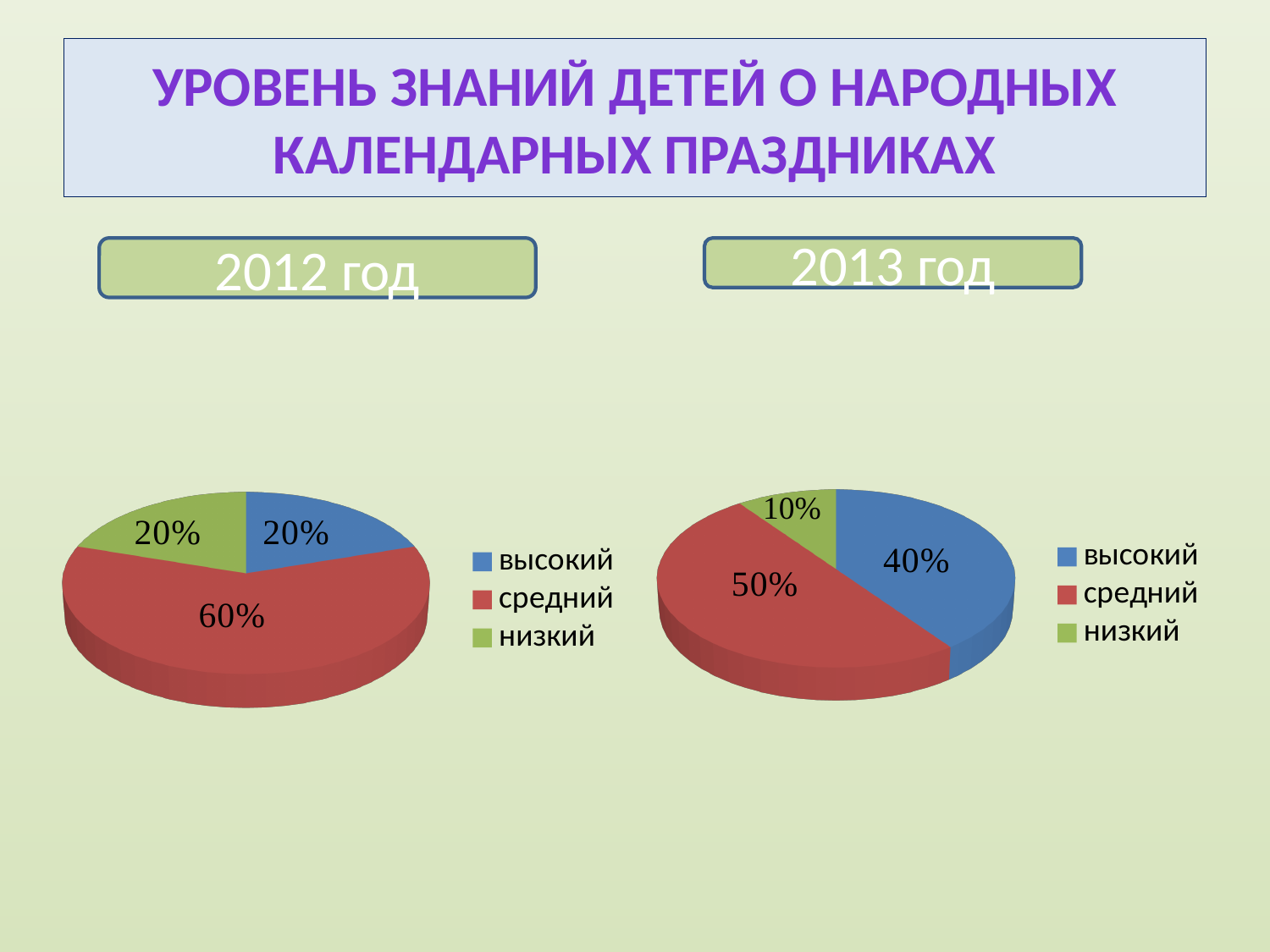
In the 2012 год pie chart, what share does the высокий slice have? 20% In the 2013 год pie chart, which is larger: the средний slice or the высокий slice? средний In the 2012 год pie chart, what share does the средний slice have? 60% In the 2013 год pie chart, what share does the высокий slice have? 40% In the 2013 год pie chart, which category has the smallest slice? низкий In the 2013 год pie chart, what share does the низкий slice have? 10% In the 2012 год pie chart, which category has the largest slice? средний Which colour represents низкий in the legend of the 2012 год chart? Green How many slices does the 2012 год pie chart have? 3 What is the difference between the средний share in the 2012 год chart and the средний share in the 2013 год chart? 10% What is the difference between the высокий share in the 2013 год chart and the высокий share in the 2012 год chart? 20% What kind of chart is used for the 2013 год data? Pie chart